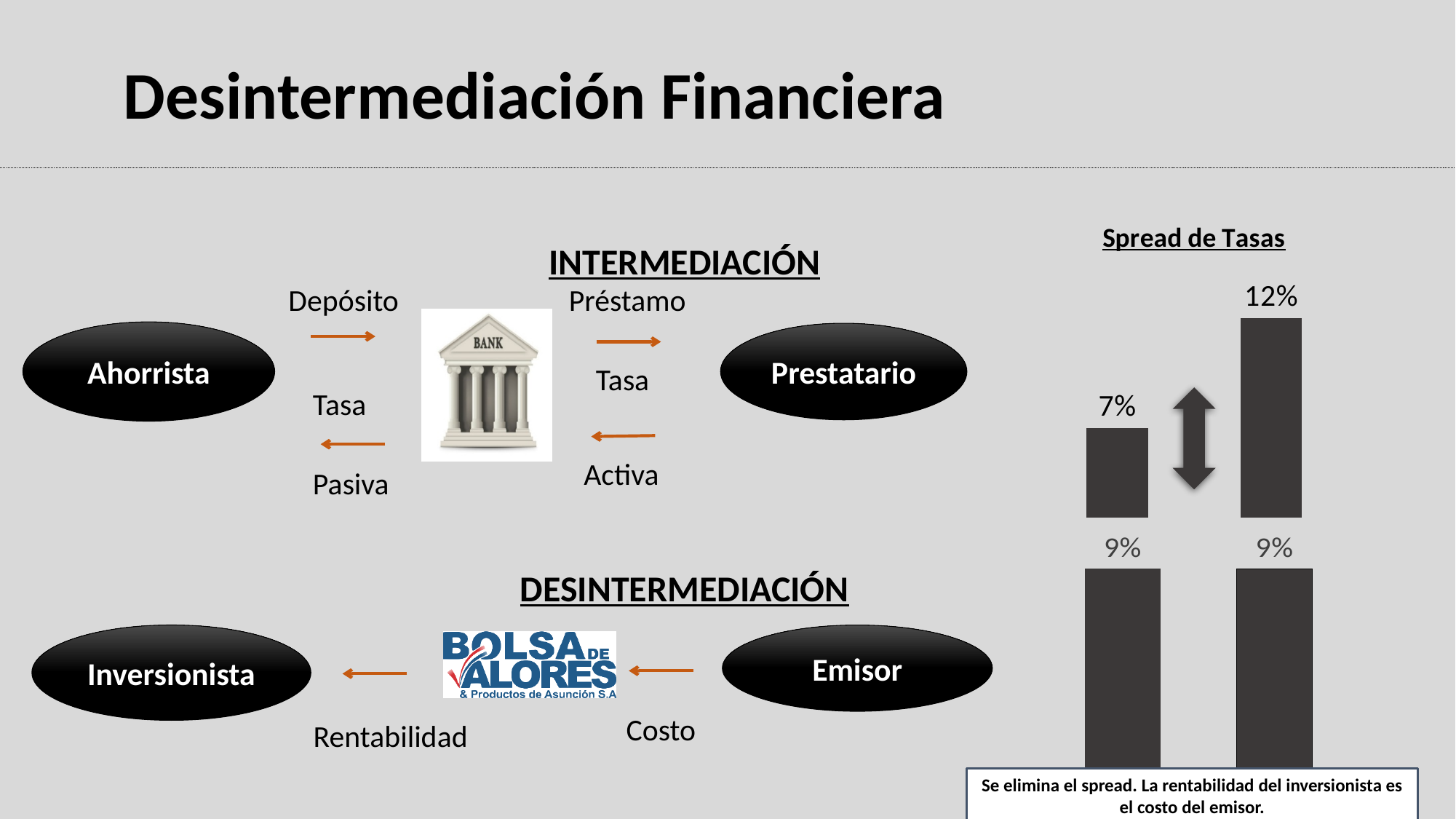
How many bars does the bottom-right chart (next to DESINTERMEDIACIÓN) have? 2 In the 'Spread de Tasas' chart at the top right, what value is shown on the left bar? 7% What colour are the bars in the 'Spread de Tasas' chart at the top right? dark grey How many bars does the 'Spread de Tasas' chart at the top right have? 2 What is the title of the bar chart at the top right of the slide? Spread de Tasas In the 'Spread de Tasas' chart at the top right, which bar is taller, the left or the right? right In the 'Spread de Tasas' chart at the top right, what value is shown on the right bar? 12% In the 'Spread de Tasas' chart at the top right, what is the difference between the right bar and the left bar? 5% In the bottom-right chart (next to DESINTERMEDIACIÓN), what is the difference between the two bars? 0% In the bottom-right chart (next to DESINTERMEDIACIÓN), what value is shown on the right bar? 9% What kind of chart is the 'Spread de Tasas' chart at the top right? bar chart In the bottom-right chart (next to DESINTERMEDIACIÓN), what value is shown on the left bar? 9%